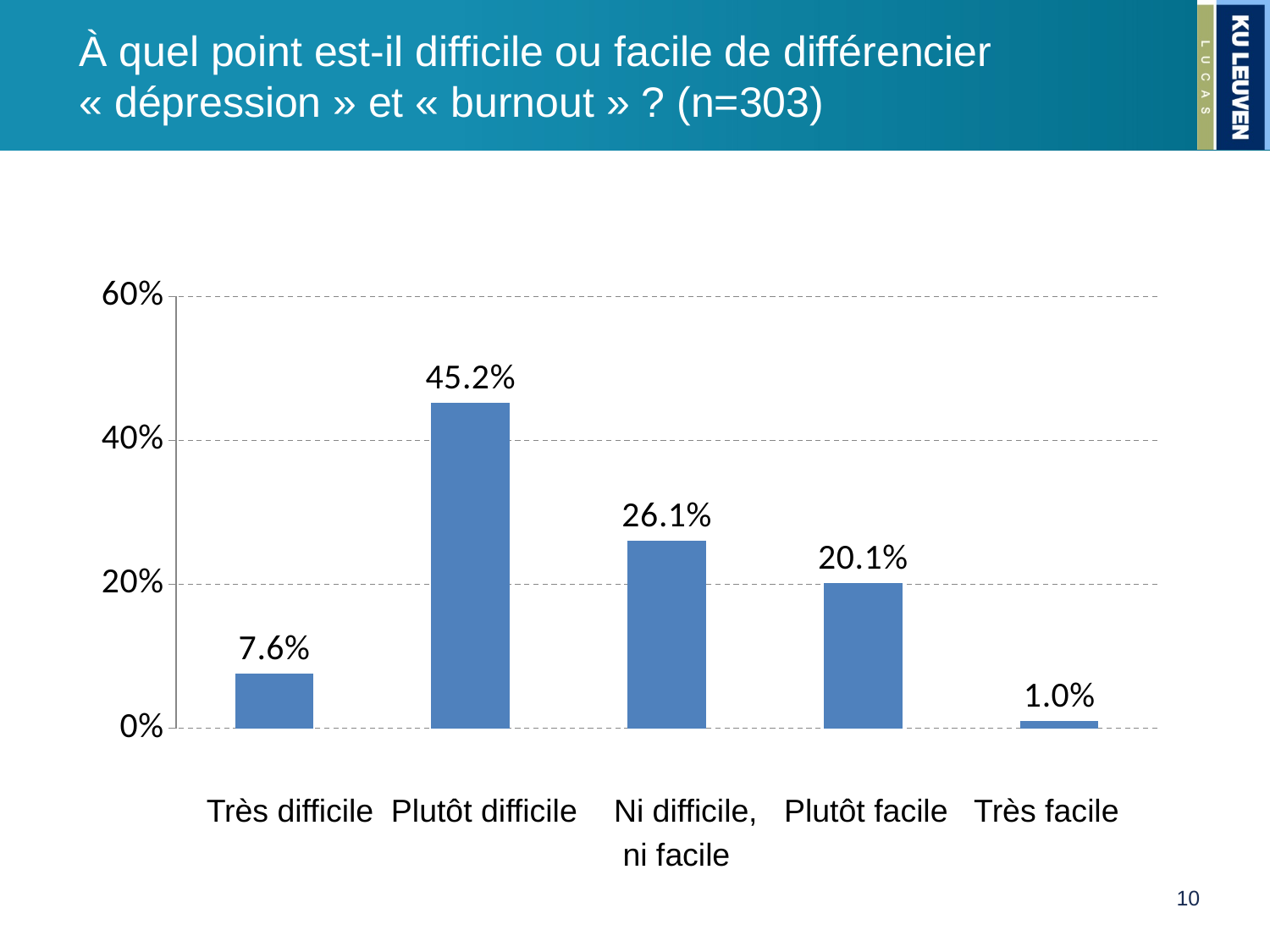
How many categories are shown on the x axis? 5 What is the difference between the values for "Très difficile" and "Très facile"? 6.6% What is the value for "Très facile"? 1.0% What is the value for "Ni difficile, ni facile"? 26.1% What is the sample size (n) stated in the slide title? 303 Which category has the highest value? Plutôt difficile What is the difference between the values for "Plutôt difficile" and "Ni difficile, ni facile"? 19.1% Which category has the lowest value? Très facile Is the value for "Plutôt difficile" greater or less than 40%? greater Which is larger, the value for "Plutôt facile" or the value for "Très difficile"? Plutôt facile What kind of chart is shown on the slide? bar chart What is the value for "Plutôt difficile"? 45.2%